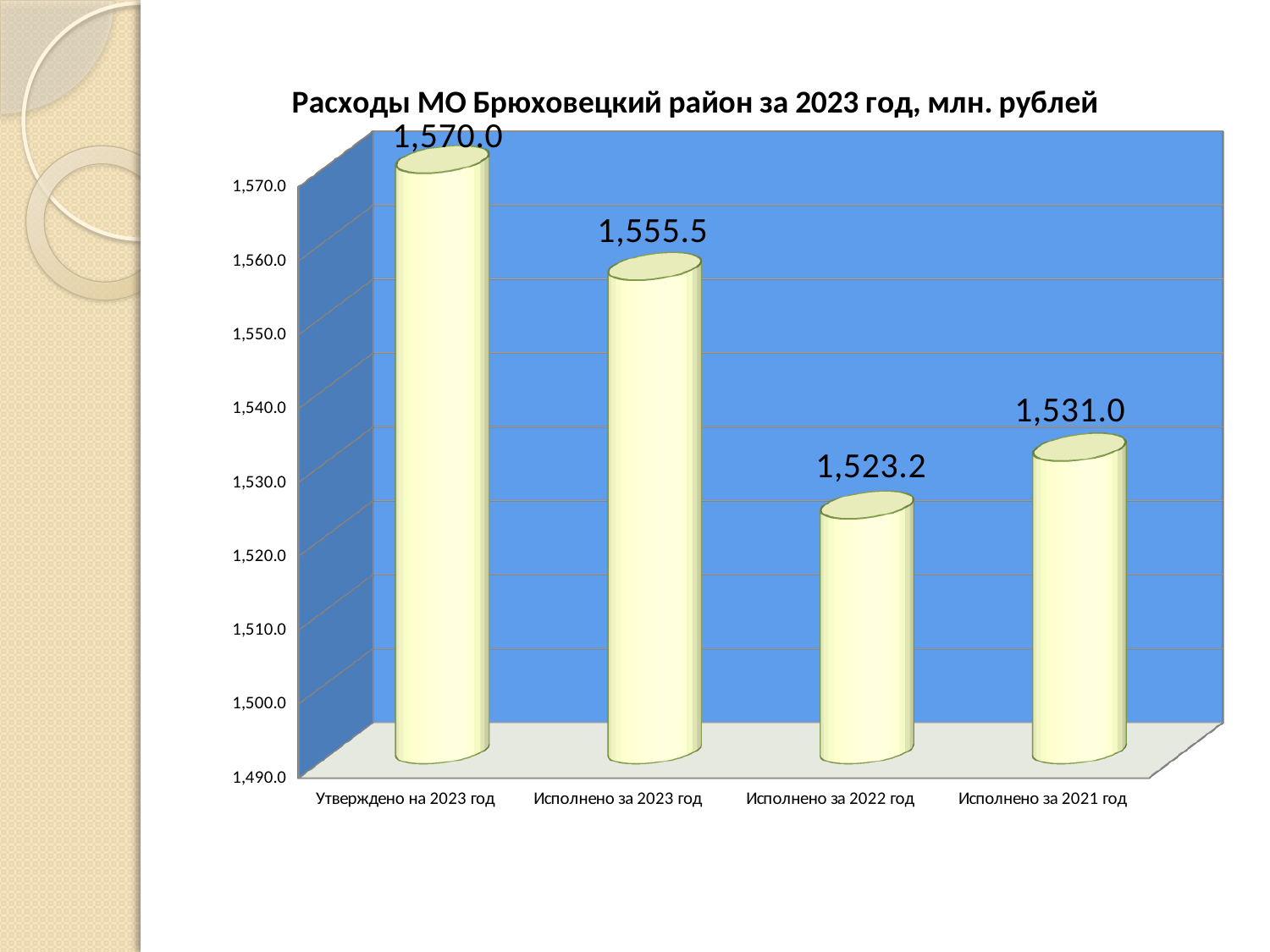
How many categories are shown on the chart? 4 What is the difference between Утверждено на 2023 год and Исполнено за 2023 год? 14.5 Which category has the highest value? Утверждено на 2023 год What is the value for Утверждено на 2023 год? 1,570.0 What is the difference between Исполнено за 2021 год and Исполнено за 2022 год? 7.8 What is the title of the chart? Расходы МО Брюховецкий район за 2023 год, млн. рублей Which category has the lowest value? Исполнено за 2022 год What is the value for Исполнено за 2022 год? 1,523.2 What is the value for Исполнено за 2021 год? 1,531.0 Which is larger, Исполнено за 2022 год or Исполнено за 2021 год? Исполнено за 2021 год What kind of chart is shown on the slide? Bar chart What is the value for Исполнено за 2023 год? 1,555.5